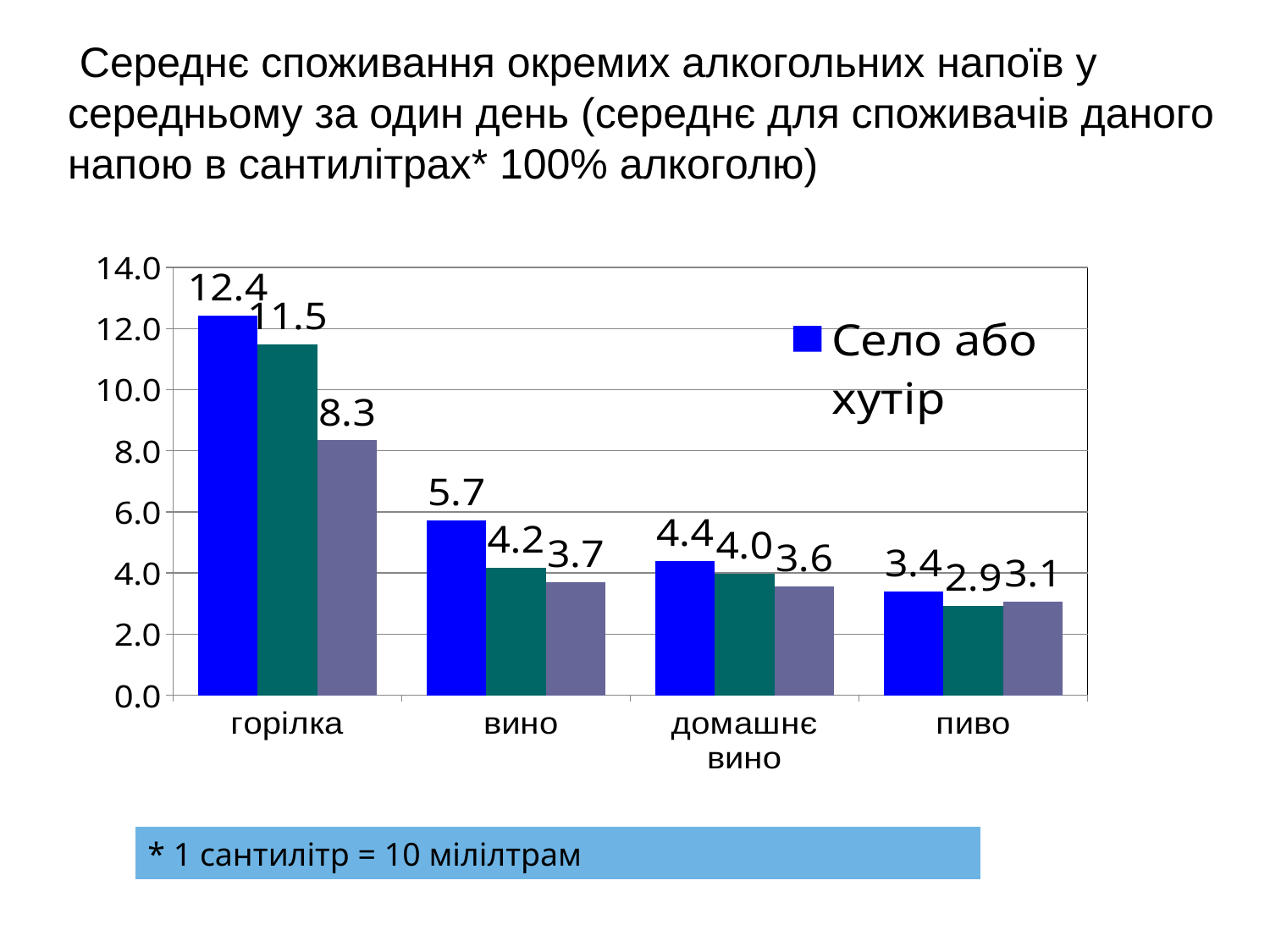
How many categories are shown on the x axis? 4 Which category has the highest value in the Село або хутір series? горілка What is the value for горілка in the Село або хутір series? 12.4 What is the difference between the Село або хутір values for горілка and вино? 6.7 Do the Село або хутір values rise or fall from горілка to пиво along the x axis? fall What kind of chart is shown on the slide? bar chart What is the value for вино in the Село або хутір series? 5.7 Which category has the lowest value in the Село або хутір series? пиво What is the value for пиво in the Село або хутір series? 3.4 Is the Село або хутір value for горілка greater or less than 10.0? greater What is the value for домашнє вино in the Село або хутір series? 4.4 In the Село або хутір series, which is larger: домашнє вино or пиво? домашнє вино